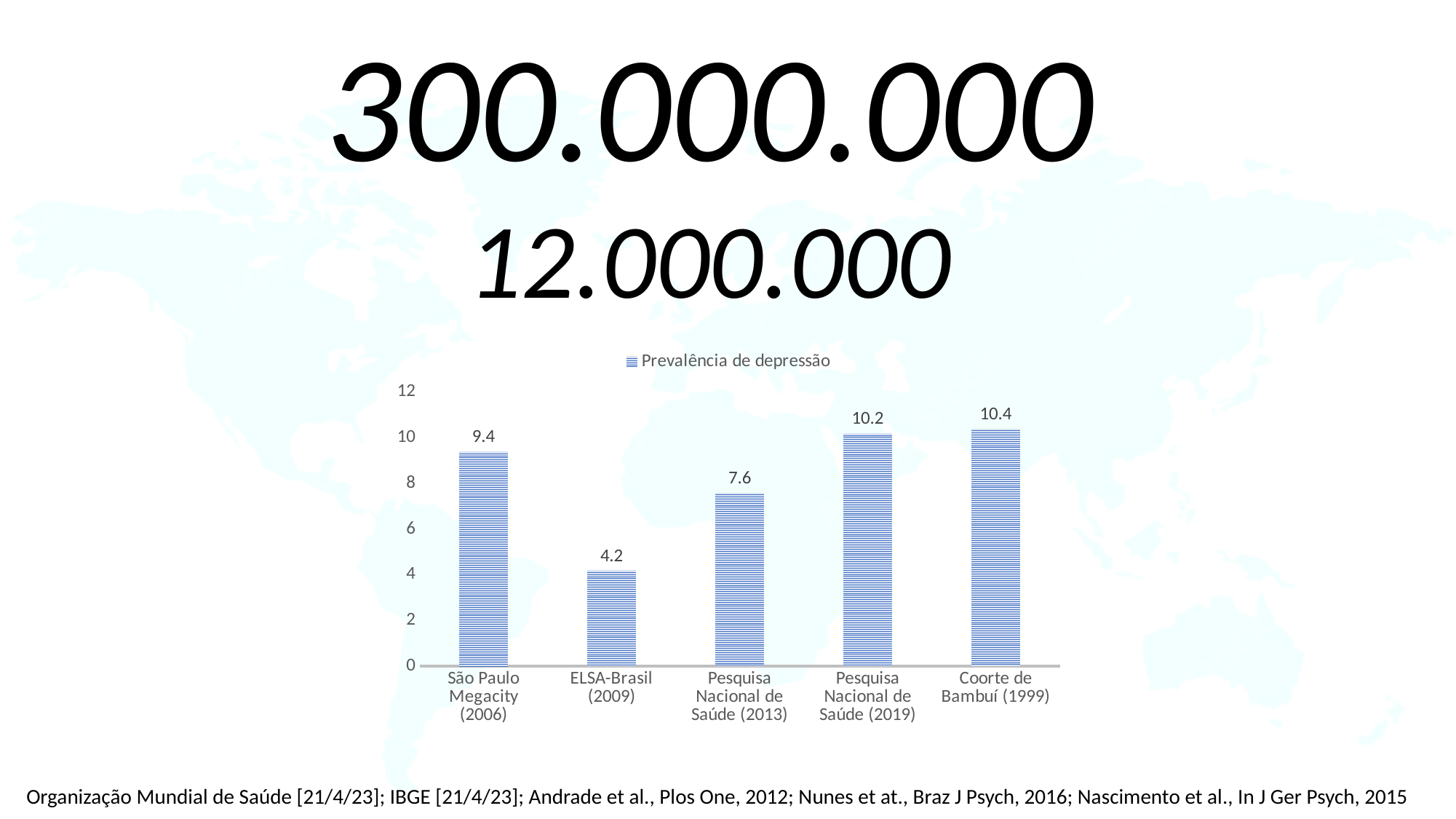
Is the value for ELSA-Brasil (2009) greater or less than 6? less Which is larger, the value for São Paulo Megacity (2006) or the value for Pesquisa Nacional de Saúde (2013)? São Paulo Megacity (2006) What is the value for São Paulo Megacity (2006)? 9.4 What kind of chart is shown on the slide? bar chart How many categories are shown on the x axis? 5 Which category has the lowest value? ELSA-Brasil (2009) What is the value for Coorte de Bambuí (1999)? 10.4 What is the value for ELSA-Brasil (2009)? 4.2 What is the value for Pesquisa Nacional de Saúde (2013)? 7.6 What is the difference between the values for Pesquisa Nacional de Saúde (2019) and Pesquisa Nacional de Saúde (2013)? 2.6 How many series does the legend list? 1 What is the name of the series shown in the legend? Prevalência de depressão